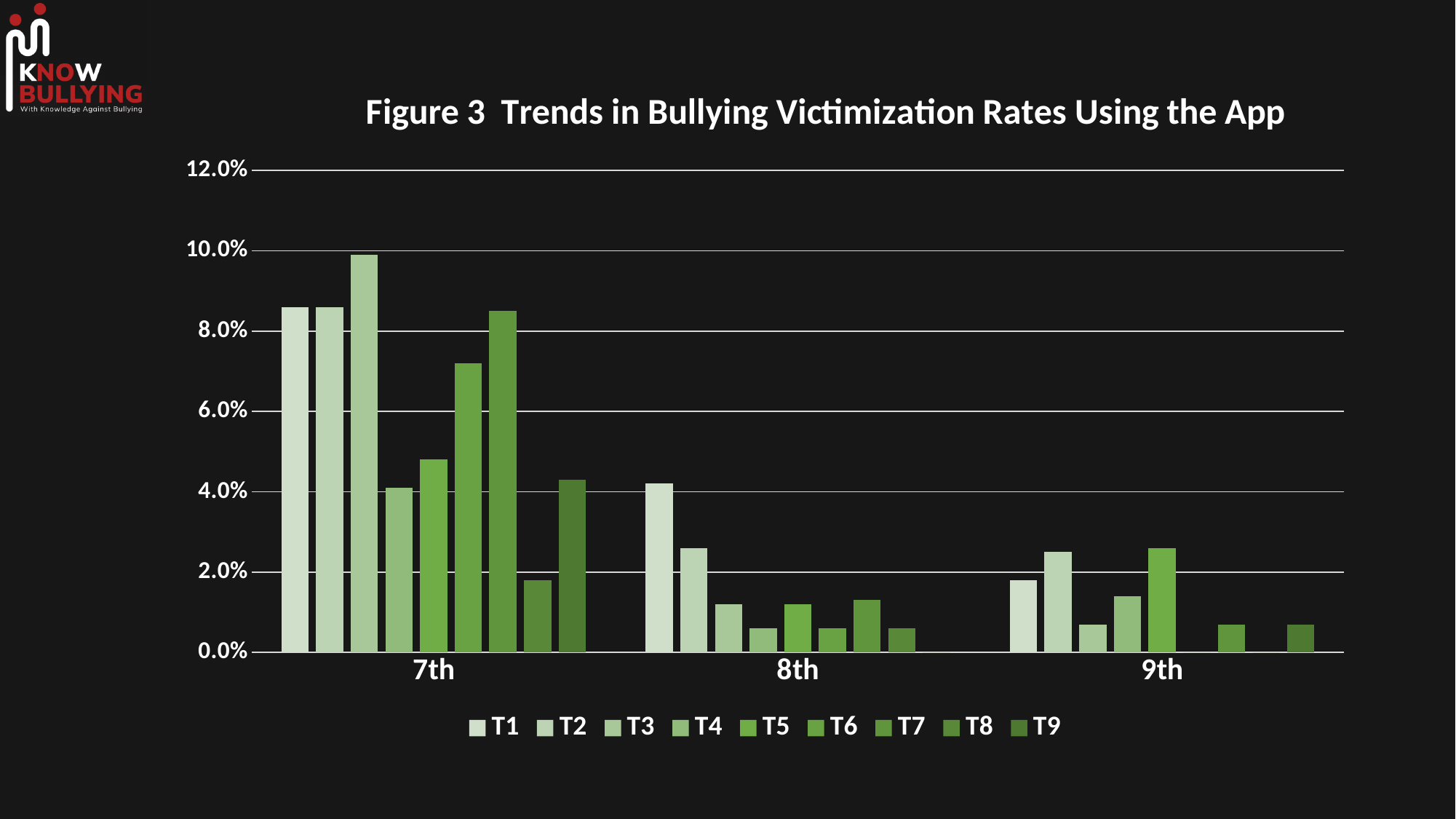
What kind of chart is shown on the slide? bar chart Which series has the lowest value for 7th grade? T8 Is the value for T1 in 8th grade greater or less than 3.0%? greater Which is larger, the T1 value for 7th grade or the T1 value for 8th grade? 7th grade Which is larger for 7th grade, T5 or T6? T6 Is the value for T4 in 7th grade greater or less than 6.0%? less What is the title of the chart? Figure 3 Trends in Bullying Victimization Rates Using the App How many series does the legend list? 9 Is the value for T3 in 7th grade greater or less than 8.0%? greater Which series has the highest value for 7th grade? T3 How many grade categories are shown on the x axis? 3 Which series has the highest value for 8th grade? T1